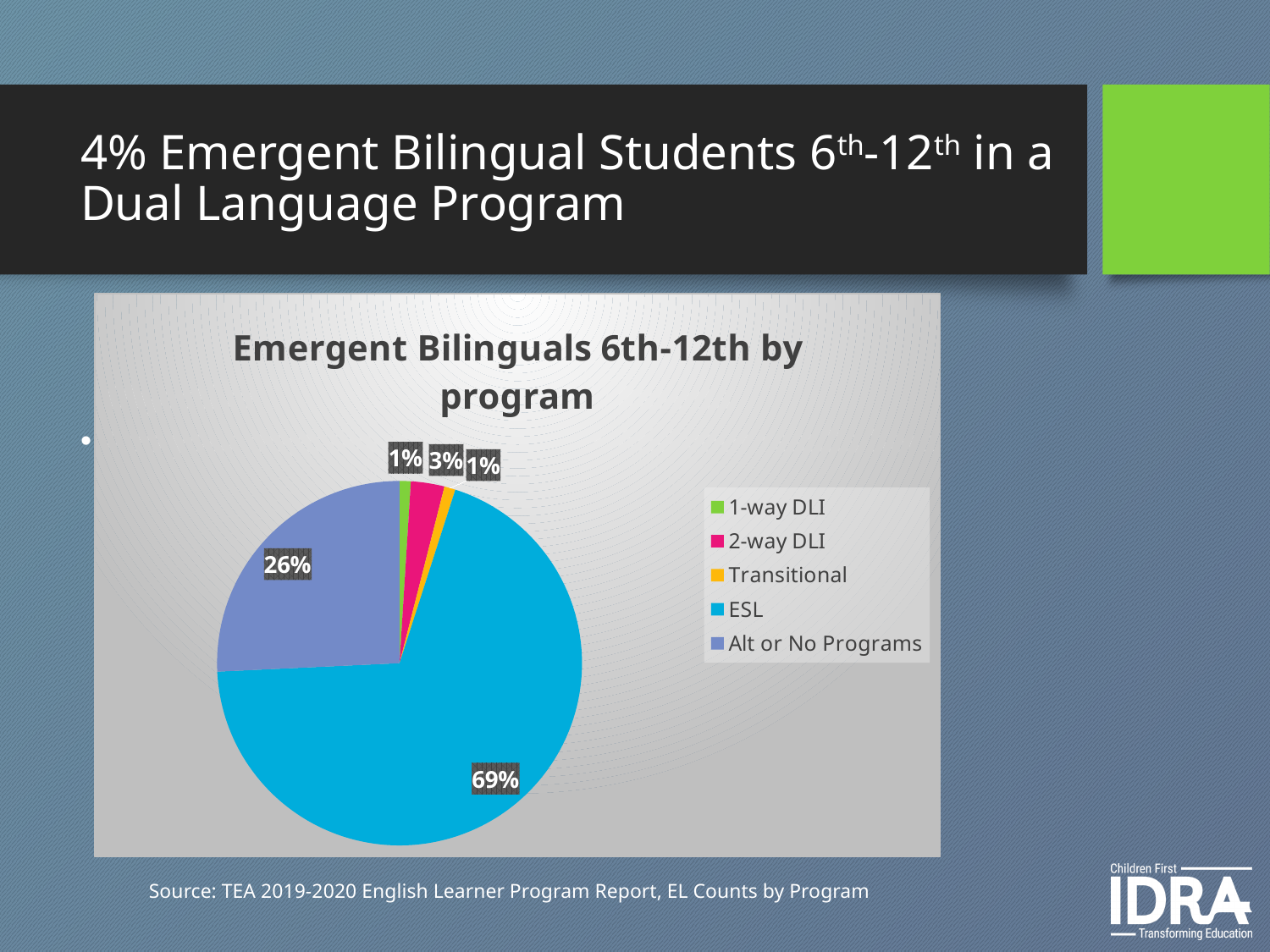
What is the difference in percentage points between ESL and Alt or No Programs? 43 What share of the pie does 2-way DLI represent? 3% How many categories does the legend list? 5 What colour is the ESL slice in the pie chart? blue Which is larger, the share for 2-way DLI or the share for Transitional? 2-way DLI What share of the pie does 1-way DLI represent? 1% What share of the pie does Transitional represent? 1% Which program has the largest slice of the pie? ESL What is the title of the chart? Emergent Bilinguals 6th-12th by program What type of chart is shown on the slide? pie chart